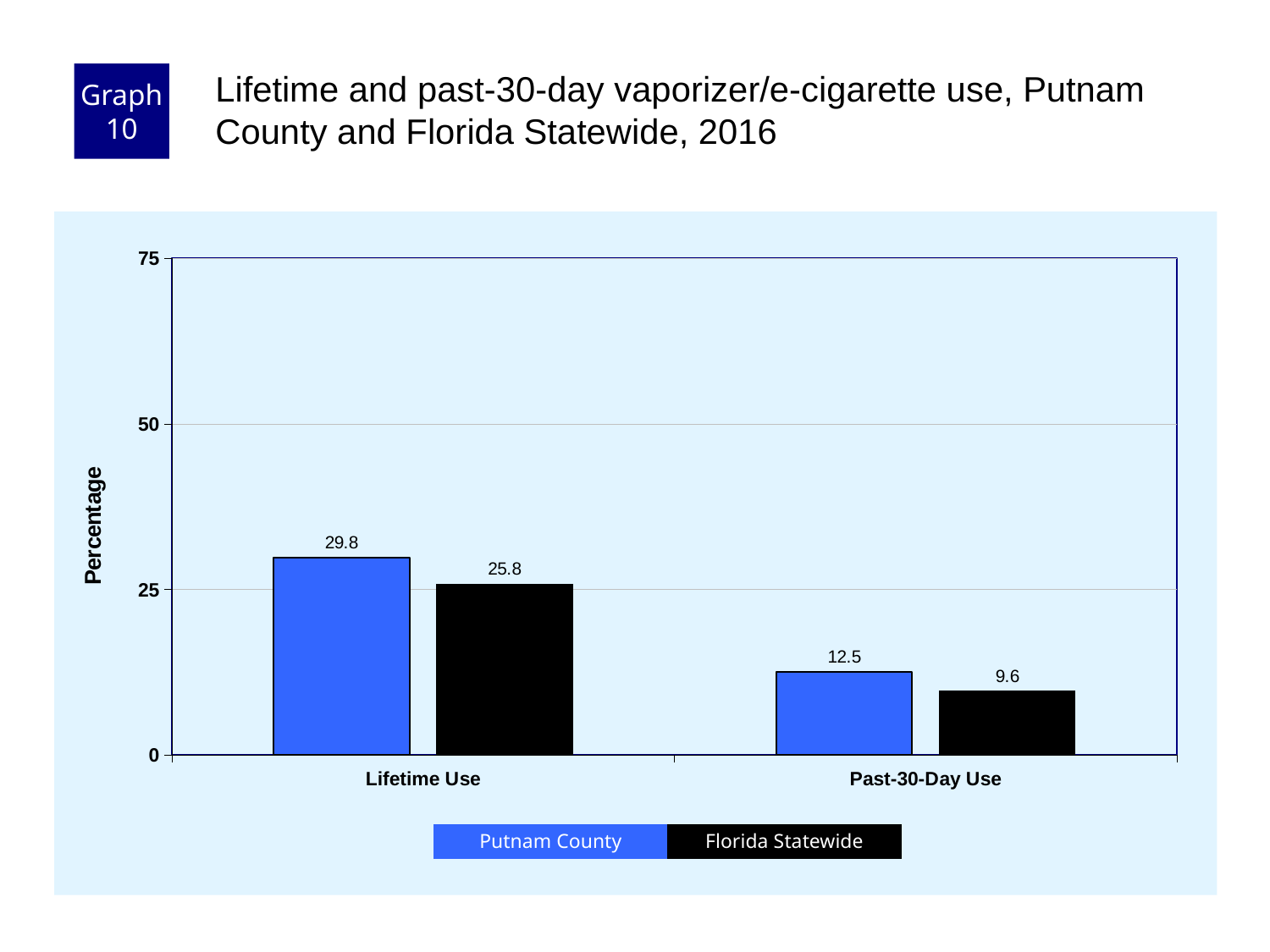
For Past-30-Day Use, which is larger: Putnam County or Florida Statewide? Putnam County What is the difference between the Putnam County and Florida Statewide values for Lifetime Use? 4.0 What is the Florida Statewide value for Lifetime Use? 25.8 What is the difference between the Putnam County and Florida Statewide values for Past-30-Day Use? 2.9 Which bar has the lowest value on the chart? Florida Statewide, Past-30-Day Use Which bar has the highest value on the chart? Putnam County, Lifetime Use What is the Florida Statewide value for Past-30-Day Use? 9.6 What is the Putnam County value for Lifetime Use? 29.8 What kind of chart is shown on the slide? Bar chart Is the Putnam County value for Lifetime Use greater or less than 25? greater How many series does the legend list? 2 What colour represents Florida Statewide in the chart? Black